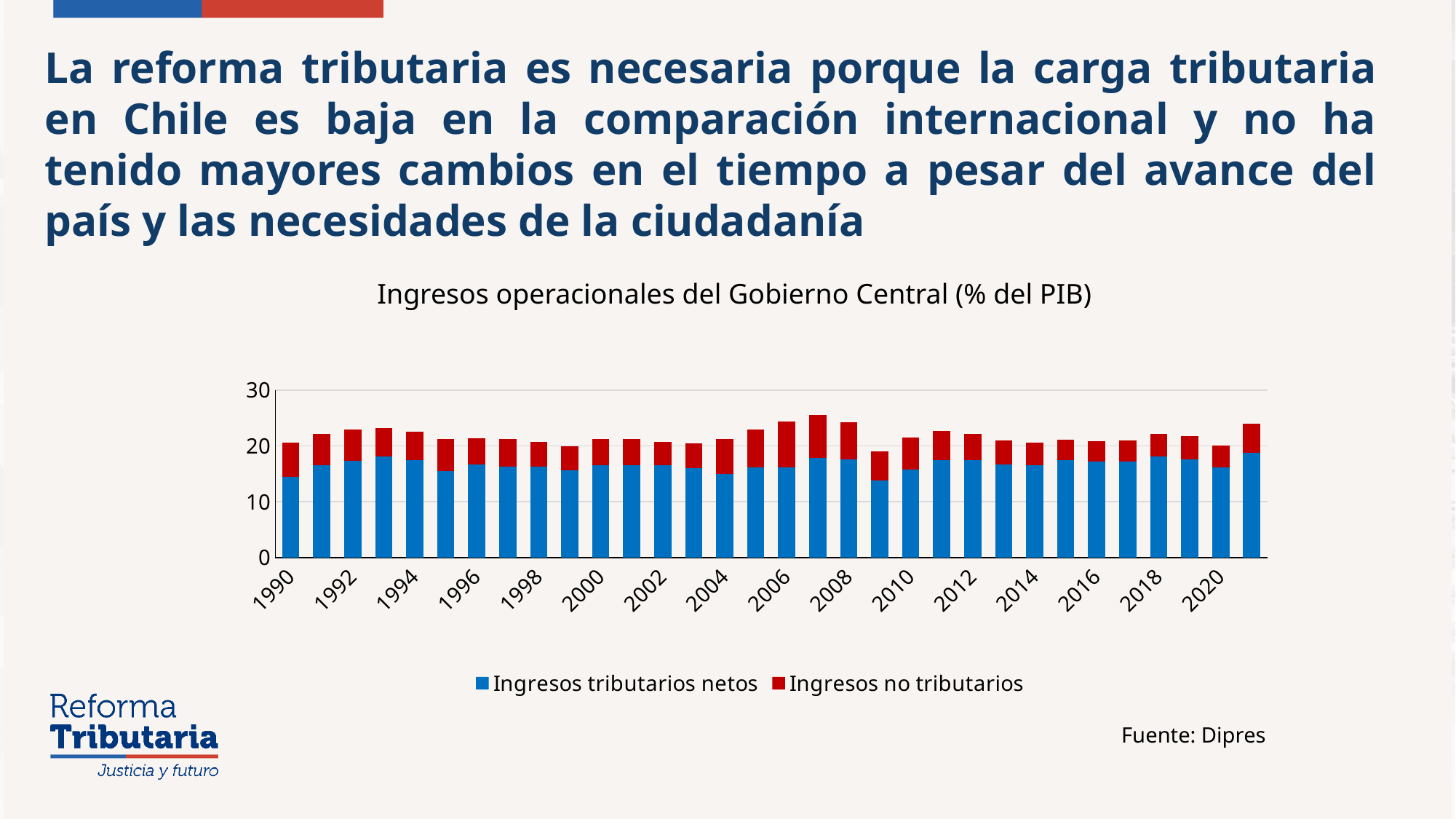
Is the total value for 1990 greater or less than 30? less What kind of chart is shown on the slide? stacked bar chart Is the value of Ingresos tributarios netos for 2007 greater or less than 10? greater What is the title of the chart? Ingresos operacionales del Gobierno Central (% del PIB) Which year has the highest total bar? 2007 Which is larger, the total bar for 2007 or the total bar for 2009? 2007 How many years (bars) are plotted in the chart? 32 How many series does the legend list? 2 Is the total value for 2007 greater or less than 20? greater Which series is shown in blue? Ingresos tributarios netos